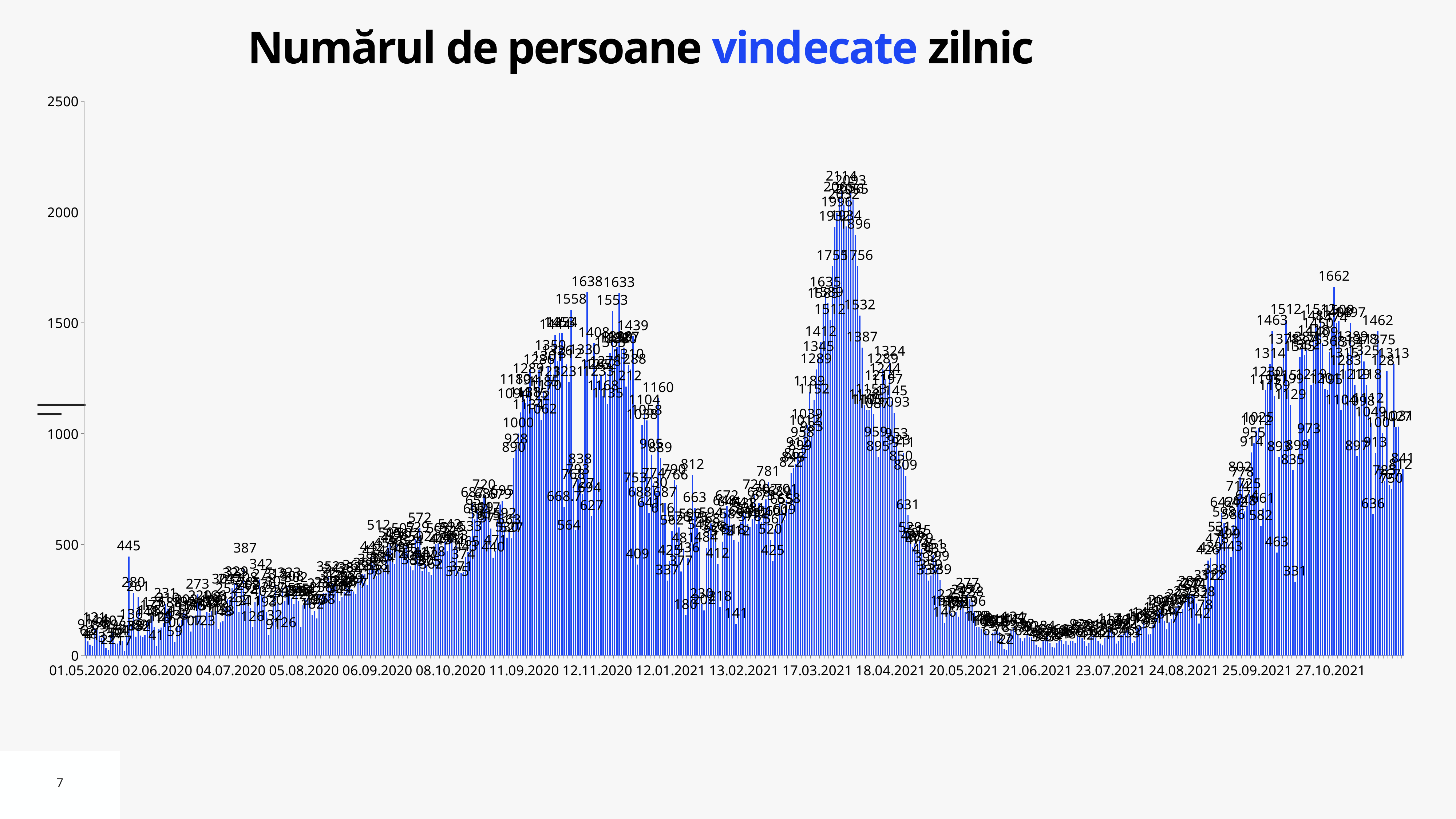
What is the maximum value shown on the vertical axis? 2500 Do the values rise or fall between 23.07.2021 and 27.10.2021? rise What is the highest value labeled in the last wave, around 27.10.2021? 1662 Is the peak value around 17.03.2021 greater or less than 2000? greater Are the values around 21.06.2021 greater or less than 500? less What is the difference between the peak labeled 2114 and the peak labeled 1662? 452 What is the title of the chart? Numărul de persoane vindecate zilnic Do the values rise or fall between 18.04.2021 and 21.06.2021? fall Which peak is higher: the one around 17.03.2021 or the one around 27.10.2021? 17.03.2021 What is the highest value labeled on the chart, at the peak around 17.03.2021? 2114 What kind of chart is shown on the slide? bar chart